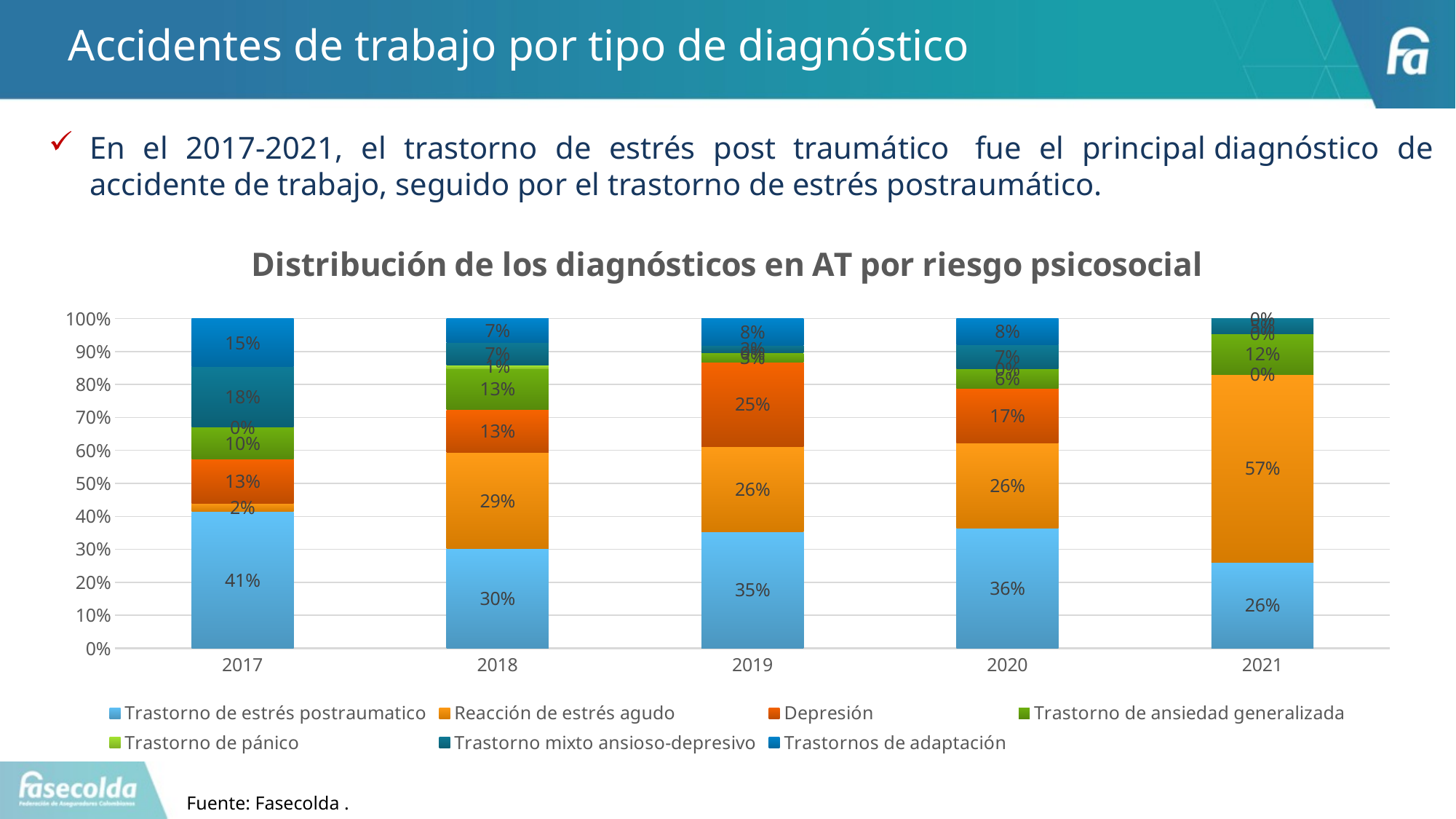
In which year is the share of Trastorno de estrés postraumatico highest? 2017 Which is larger in 2018: Trastorno de estrés postraumatico or Reacción de estrés agudo? Trastorno de estrés postraumatico What is the value for Reacción de estrés agudo in 2021? 57% What is the value for Trastorno mixto ansioso-depresivo in 2017? 18% What percentage does Trastorno de estrés postraumatico represent in 2017? 41% What is the difference between the Reacción de estrés agudo share in 2021 and in 2020? 31% How many series does the legend list? 7 What kind of chart is shown on the slide? Stacked bar chart What percentage does Depresión account for in 2019? 25% Is the Depresión share in 2020 greater or less than 20%? less In which year is the share of Trastorno de estrés postraumatico lowest? 2021 How many years are shown on the x axis of the chart? 5